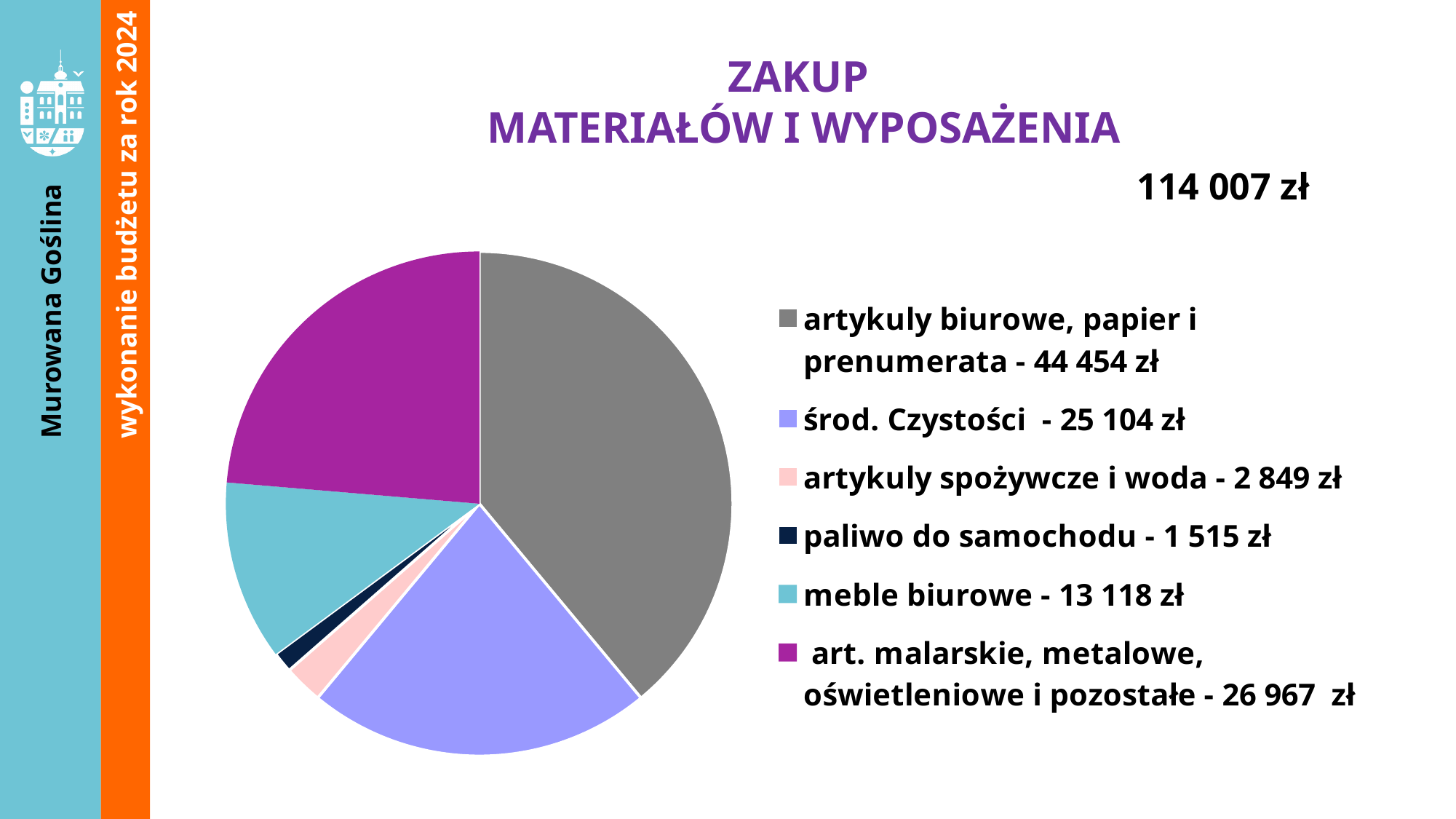
How many categories does the pie chart have? 6 What is the value for "paliwo do samochodu"? 1 515 zł What is the value for "art. malarskie, metalowe, oświetleniowe i pozostałe"? 26 967 zł What type of chart is shown on the slide? pie chart What is the value for "meble biurowe"? 13 118 zł Which is larger: "środ. Czystości" or "art. malarskie, metalowe, oświetleniowe i pozostałe"? art. malarskie, metalowe, oświetleniowe i pozostałe What is the value for "artykuly biurowe, papier i prenumerata"? 44 454 zł What is the difference between "artykuly biurowe, papier i prenumerata" and "środ. Czystości"? 19 350 zł What is the total amount shown for the whole pie chart? 114 007 zł What is the difference between "meble biurowe" and "artykuly spożywcze i woda"? 10 269 zł Which category has the largest slice of the pie? artykuly biurowe, papier i prenumerata Which category has the smallest slice of the pie? paliwo do samochodu